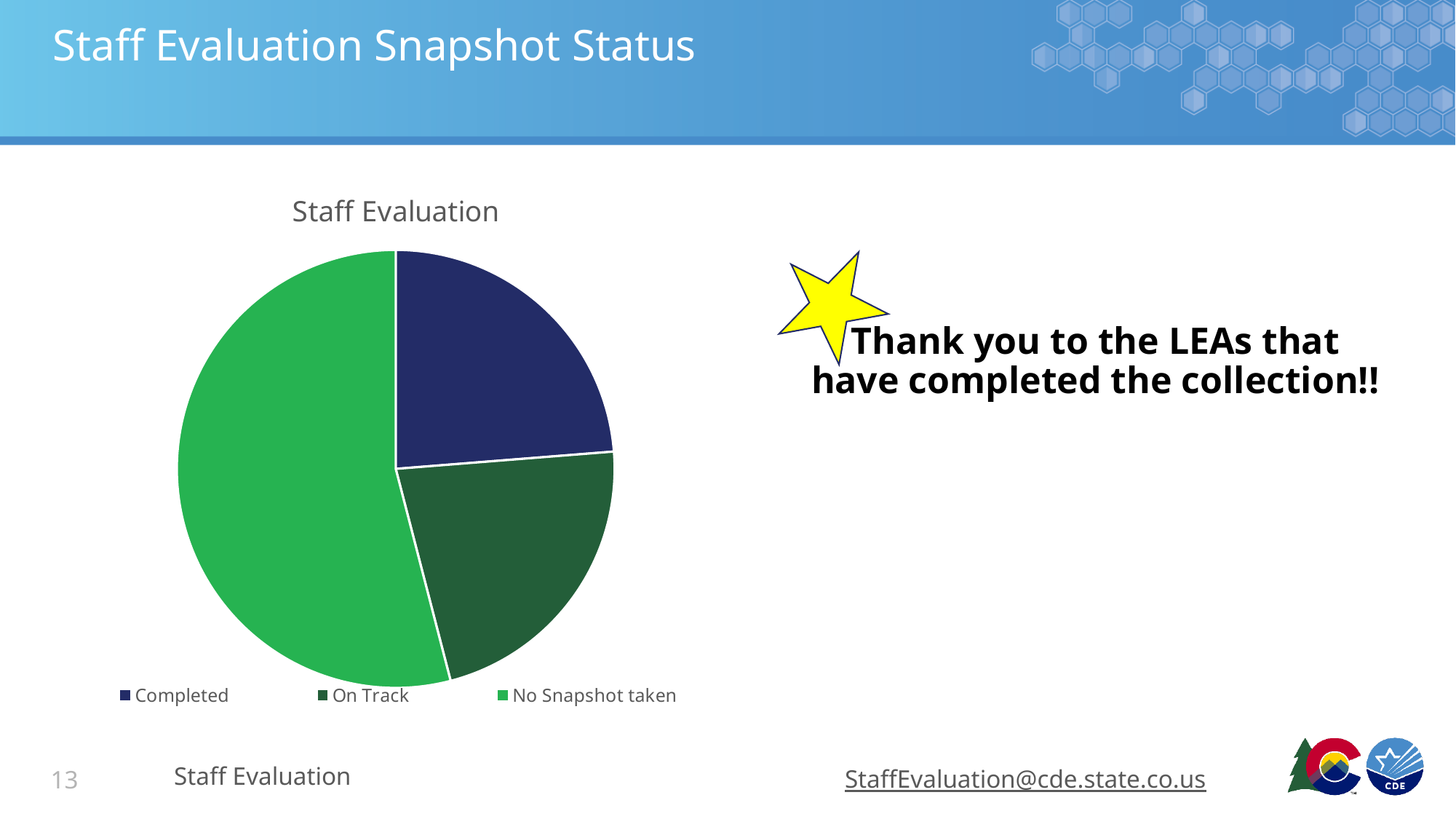
Which category has the largest slice of the pie? No Snapshot taken Which slice is larger, No Snapshot taken or Completed? No Snapshot taken What are the three categories listed in the legend? Completed, On Track, No Snapshot taken How many entries does the chart legend list? 3 Which slice is larger, No Snapshot taken or On Track? No Snapshot taken How many slices does the pie chart have? 3 What colour is the Completed slice in the pie chart? dark blue Does the No Snapshot taken slice make up more or less than half of the pie? more What kind of chart is shown on the slide? pie chart What is the title of the chart? Staff Evaluation